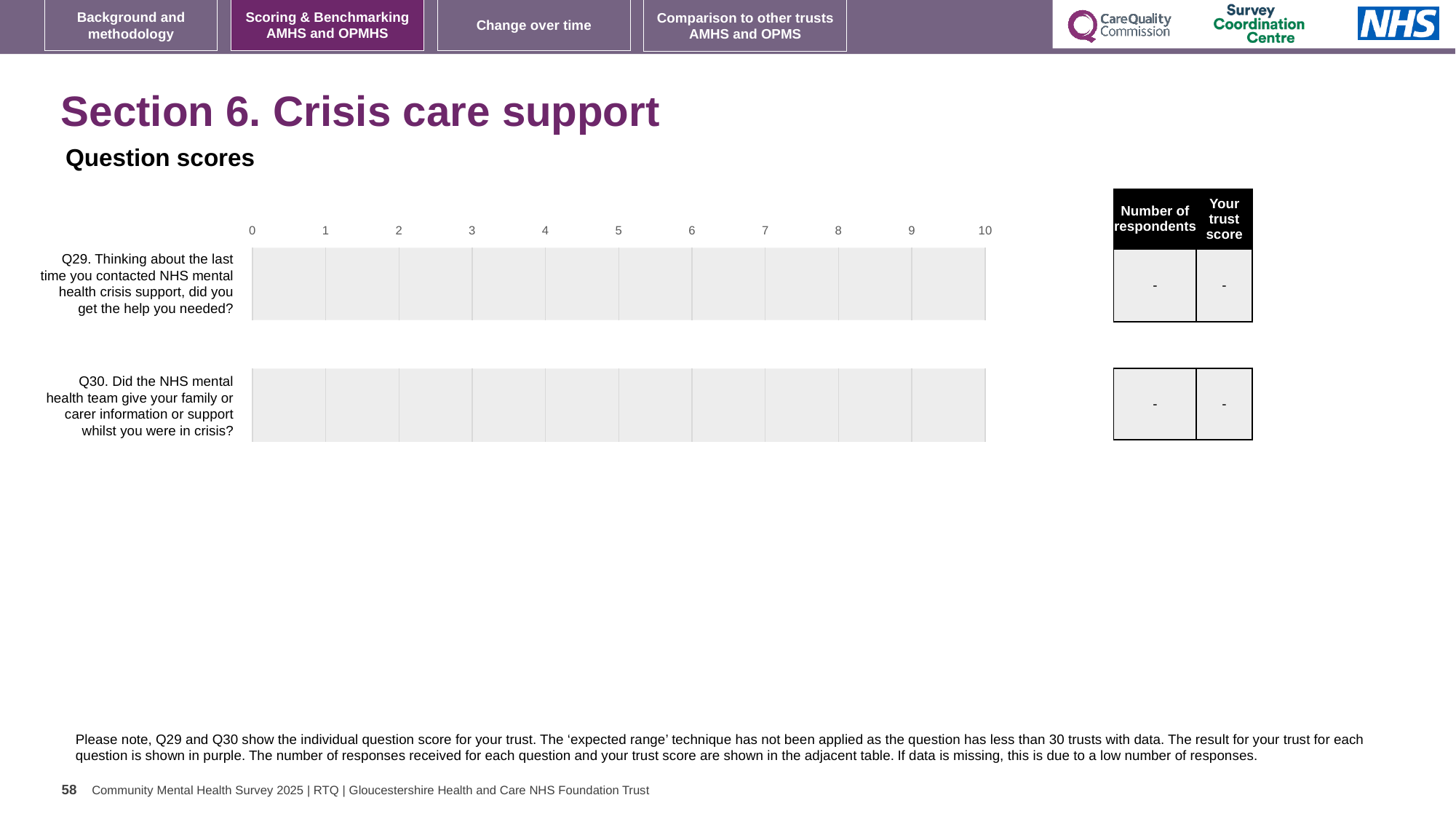
What kind of chart is used to display the question scores? bar chart What is the heading shown above the chart? Question scores How many questions are listed as categories on the chart? 2 What is the 'Your trust score' value shown in the table for Q29? - What is the highest value shown on the chart's x axis? 10 What is the 'Number of respondents' value shown in the table for Q30? - What is the 'Number of respondents' value shown in the table for Q29? - What is the 'Your trust score' value shown in the table for Q30? -